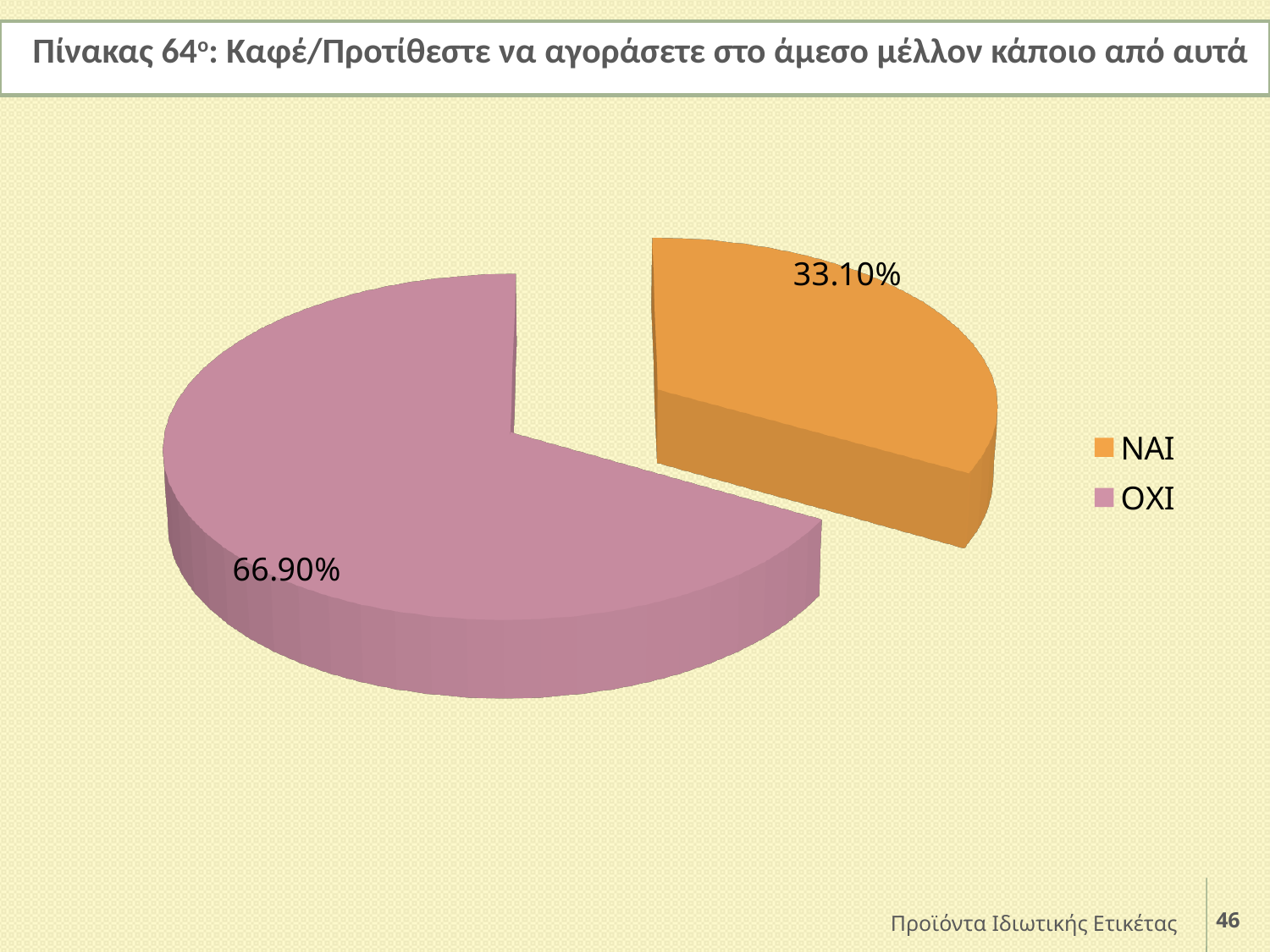
What colour is the ΝΑΙ slice? orange What is the difference between the ΟΧΙ and ΝΑΙ values? 33.80% What is the value for ΟΧΙ? 66.90% What kind of chart is shown on the slide? pie chart How many entries does the legend list? 2 What colour is the ΟΧΙ slice? pink Which category has the largest slice? ΟΧΙ What share of the pie does ΝΑΙ represent? 33.10% Which is larger, ΝΑΙ or ΟΧΙ? ΟΧΙ What is the value for ΝΑΙ? 33.10% Which category has the smallest slice? ΝΑΙ How many slices does the pie chart have? 2